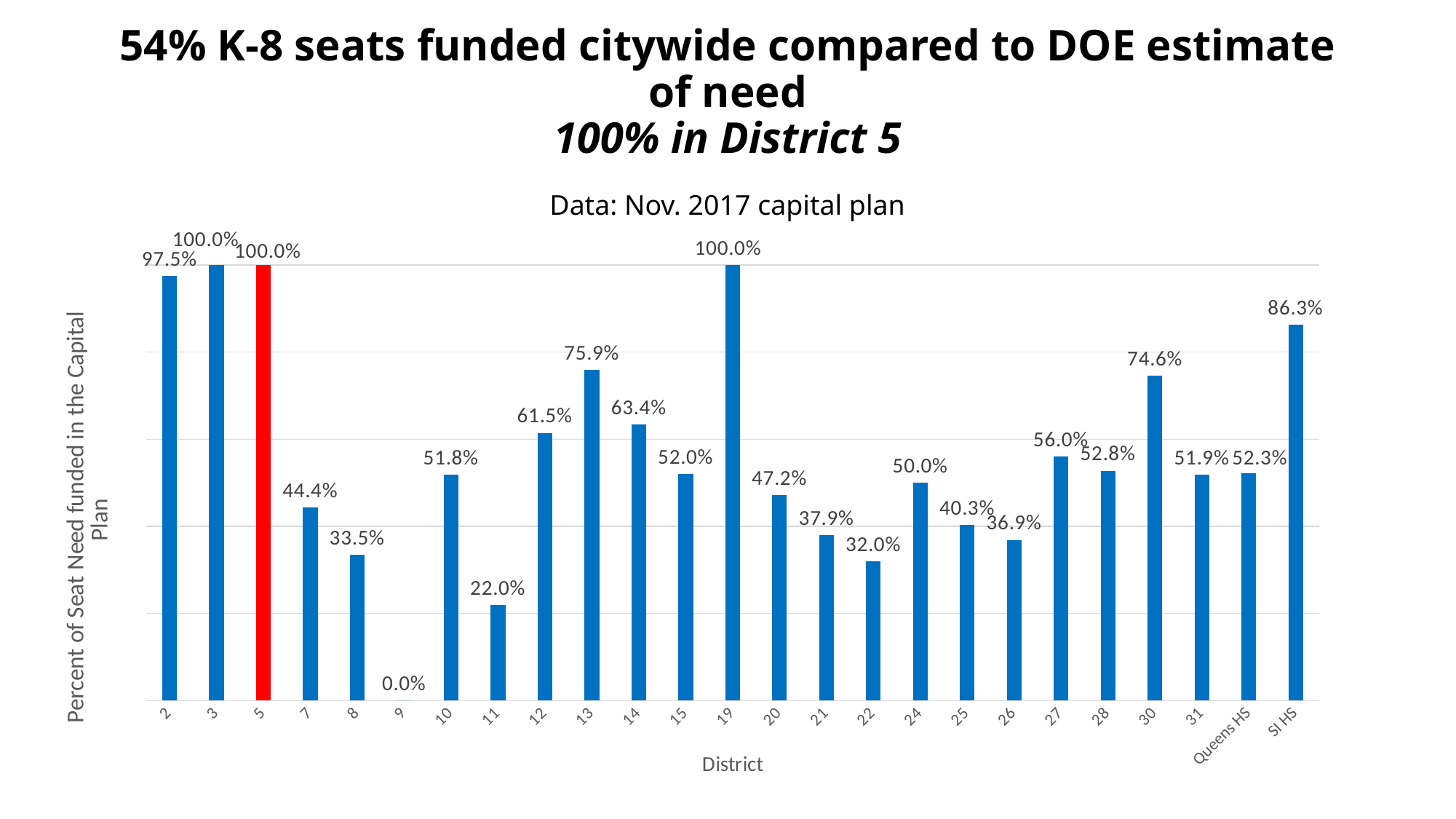
What is the difference between the values for SI HS and District 30? 11.7% What is the value for District 13? 75.9% What is the value for Queens HS? 52.3% Which is larger, the value for District 14 or the value for District 20? District 14 How many districts are shown on the x axis? 25 What is the value for District 11? 22.0% Which district's bar is coloured red? 5 What is the difference between the values for District 13 and District 12? 14.4% What kind of chart is shown on the slide? Bar chart What is the value for SI HS? 86.3% What is the value for District 30? 74.6% Which district has the lowest percent of seat need funded? 9